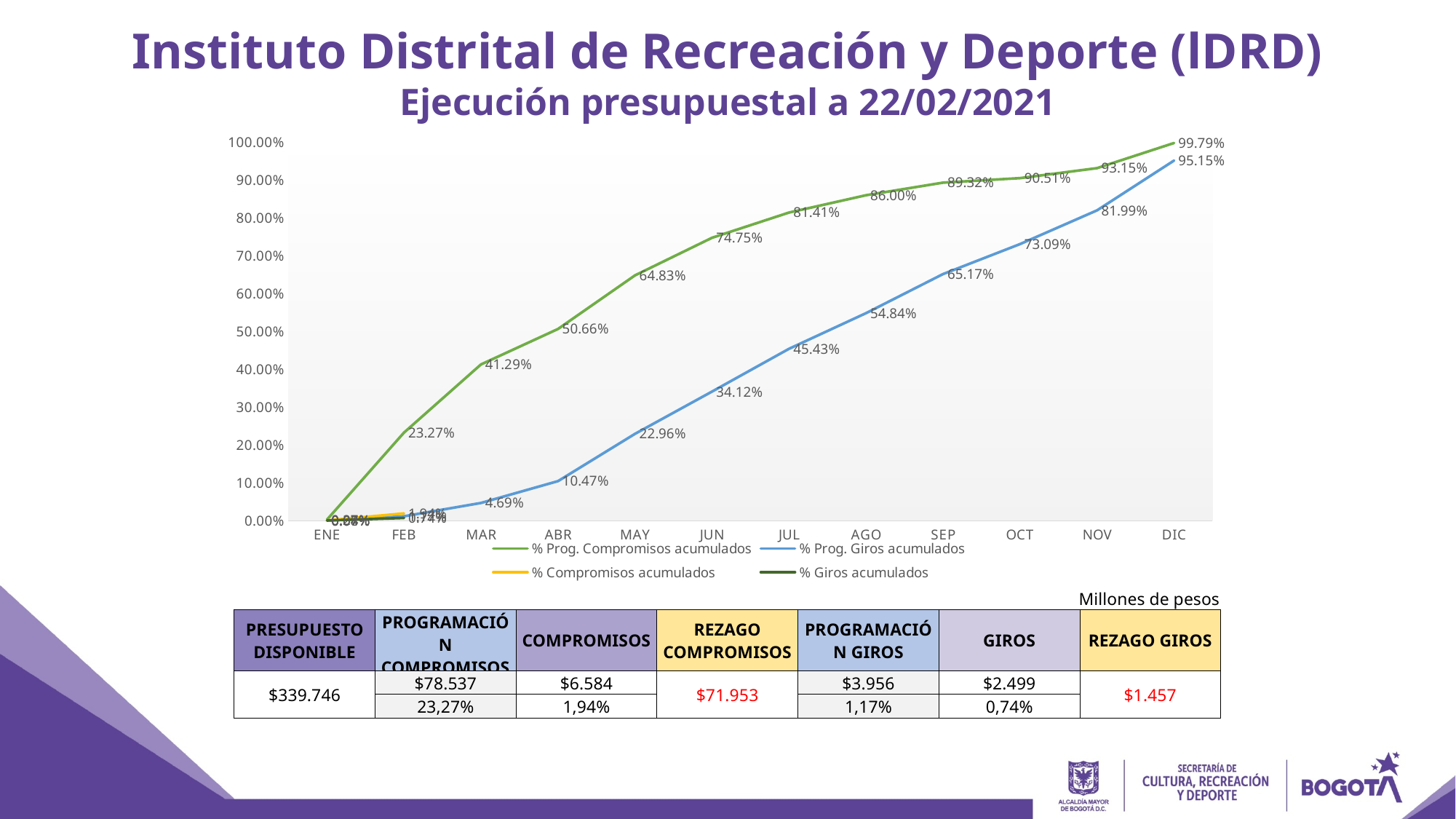
How many series does the chart legend list? 4 What is the value of % Prog. Compromisos acumulados in DIC? 99.79% Which is larger in SEP: % Prog. Compromisos acumulados or % Prog. Giros acumulados? % Prog. Compromisos acumulados What is the difference between % Prog. Compromisos acumulados and % Prog. Giros acumulados in JUN? 40.63% Does % Prog. Compromisos acumulados rise or fall from ENE to DIC? rise How many months are shown on the x axis of the chart? 12 In which month does % Prog. Giros acumulados reach its highest value? DIC What type of chart is shown on the slide? line chart What is the value of % Prog. Giros acumulados in JUL? 45.43% What is the value of % Prog. Compromisos acumulados in MAR? 41.29% What is the value of % Prog. Giros acumulados in NOV? 81.99%